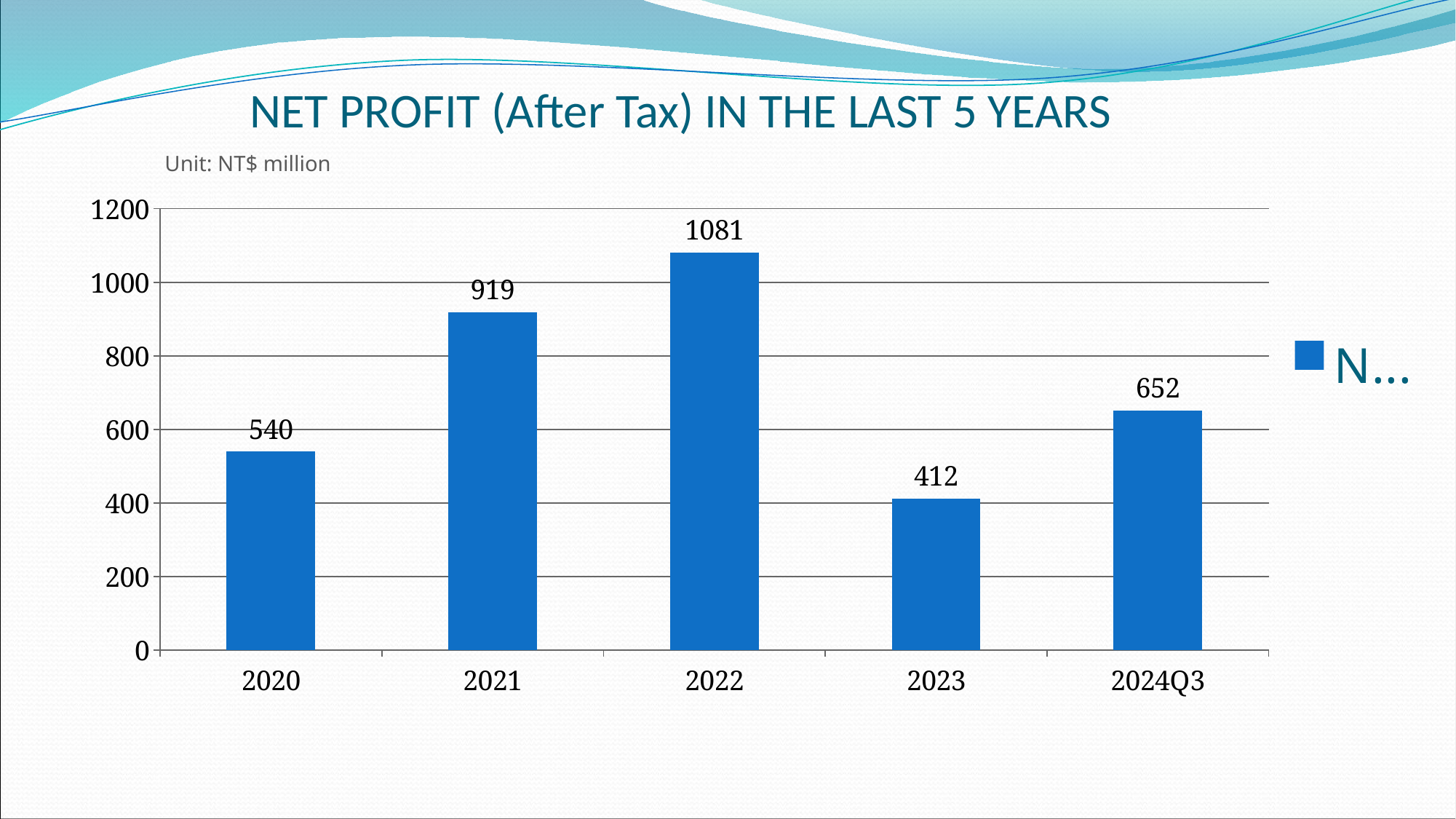
What unit is stated for the values in the chart? NT$ million Which is larger, the net profit for 2021 or for 2024Q3? 2021 How many bars are shown in the chart? 5 What is the net profit value for 2022? 1081 Which year has the lowest net profit? 2023 What is the difference between the net profit in 2021 and in 2020? 379 Is the value for 2023 greater or less than 600? less What is the difference between the net profit in 2022 and in 2023? 669 What is the net profit value for 2020? 540 Which year has the highest net profit? 2022 What kind of chart is shown on the slide? bar chart What is the net profit value for 2024Q3? 652